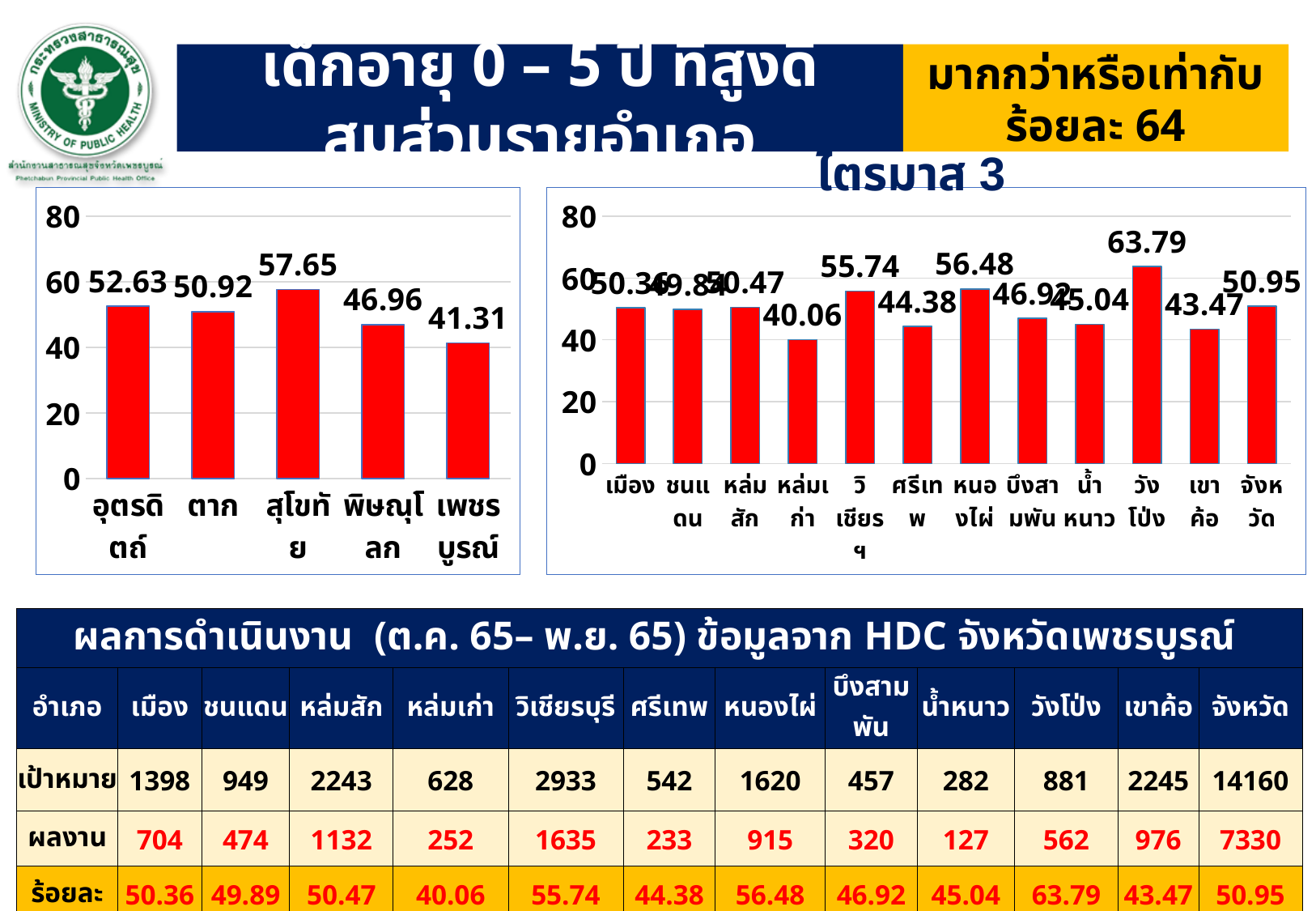
In the right chart, what is the value for หล่มเก่า? 40.06 What type of chart is the right chart? bar chart In the left chart, what is the value for เพชรบูรณ์? 41.31 In the right chart, what is the value for วังโป่ง? 63.79 In the right chart, which is larger, the value for วิเชียรบุรี or the value for หนองไผ่? หนองไผ่ In the left chart, which category has the lowest value? เพชรบูรณ์ In the left chart, what is the difference between the values for อุตรดิตถ์ and ตาก? 1.71 How many categories are shown in the left chart? 5 In the left chart, what is the value for สุโขทัย? 57.65 In the left chart, which category has the highest value? สุโขทัย In the right chart, which category has the highest value? วังโป่ง In the right chart, which category has the lowest value? หล่มเก่า